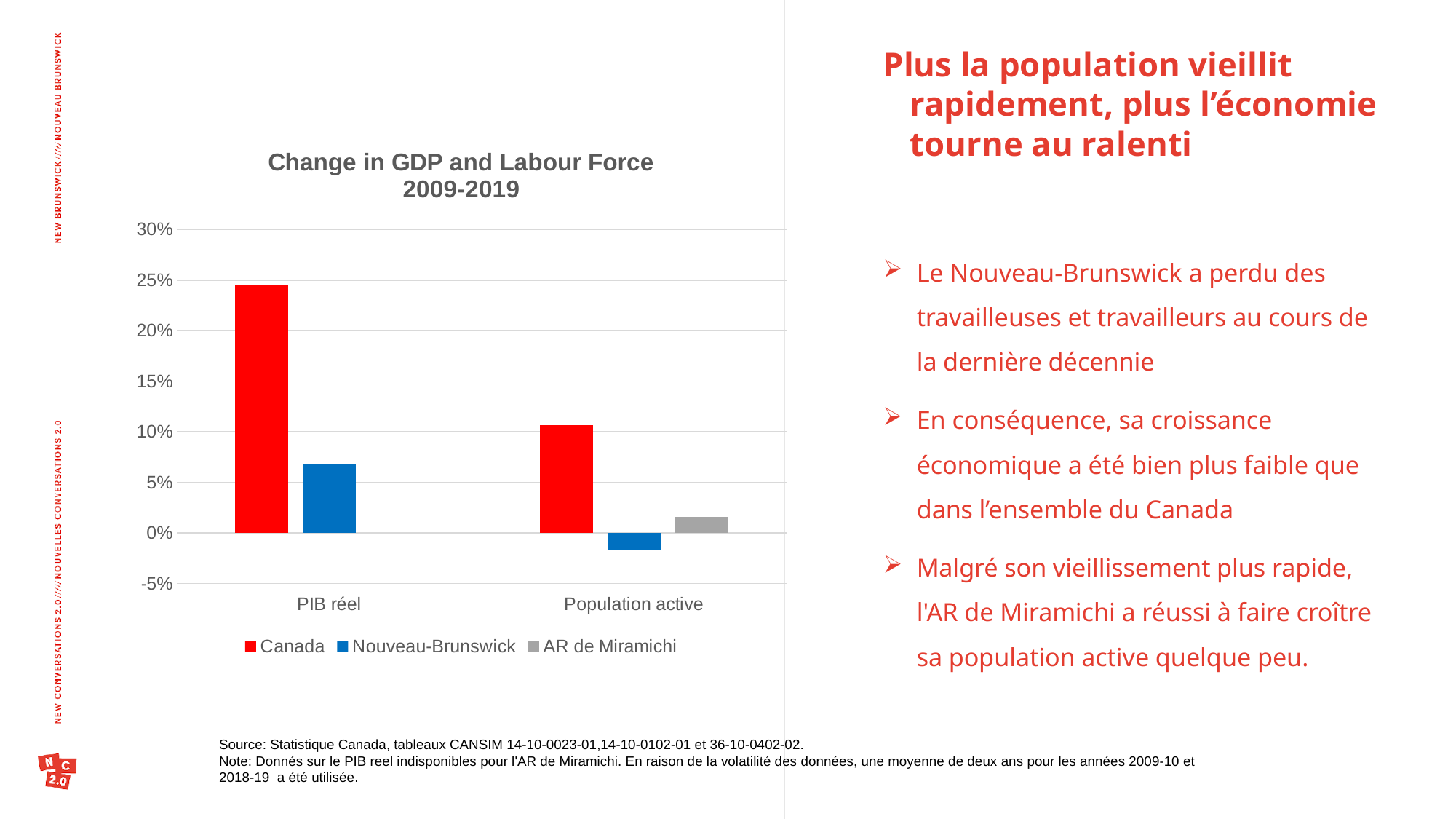
What is the title of the chart? Change in GDP and Labour Force 2009-2019 Which colour represents the Canada series in the chart? red How many categories are shown on the x axis of the chart? 2 Which series has the highest value for PIB réel? Canada Is the value for Nouveau-Brunswick in Population active greater or less than 0%? less Which series has the lowest value for Population active? Nouveau-Brunswick What kind of chart is shown on the slide? bar chart How many series does the chart legend list? 3 For PIB réel, which is larger: the value for Canada or the value for Nouveau-Brunswick? Canada Is the value for AR de Miramichi in Population active greater or less than 5%? less Is the value for Canada in PIB réel greater or less than 20%? greater